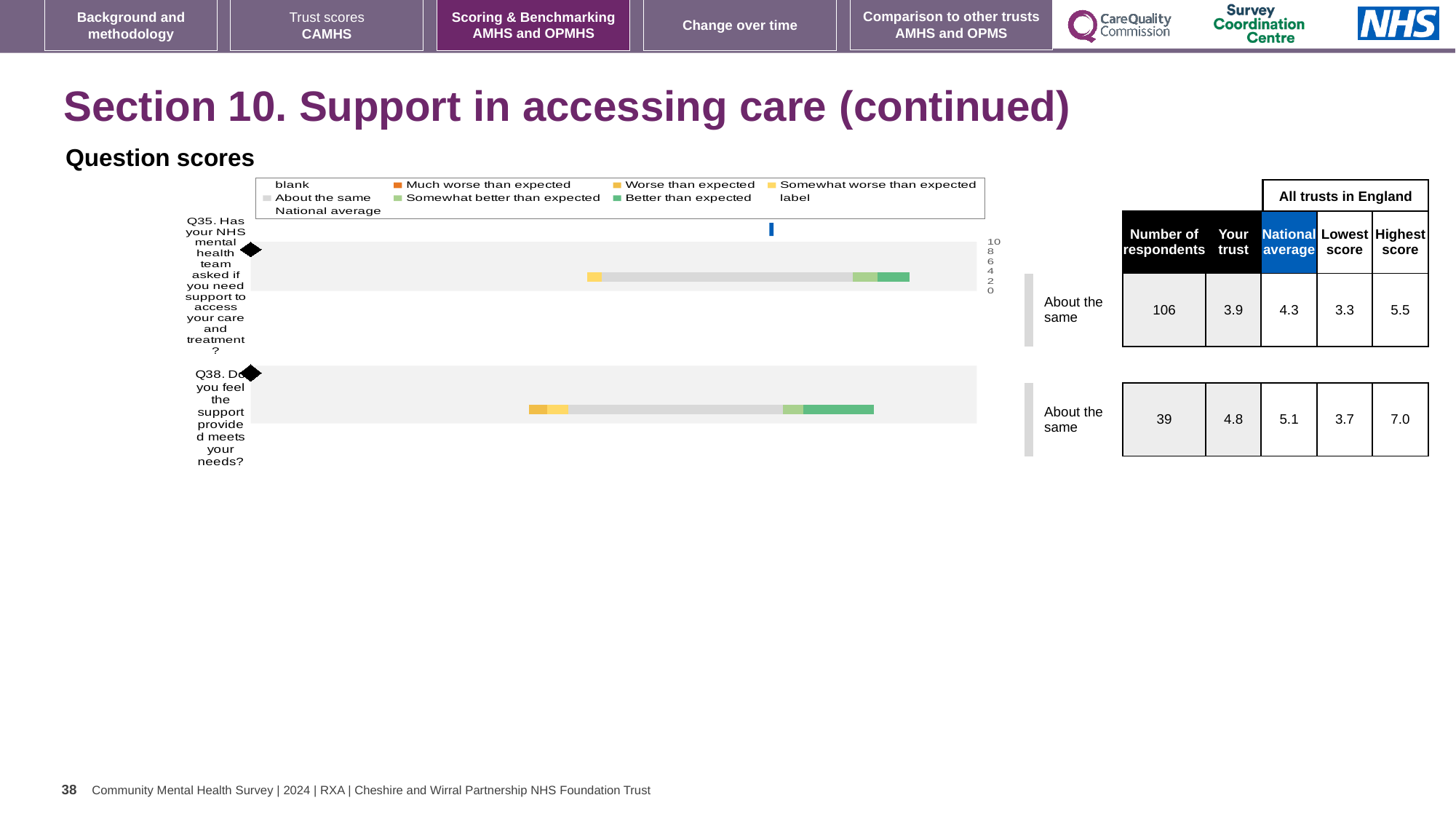
Which question has the higher 'Your trust' score in the table, Q35 or Q38? Q38 In the table beside the chart, what is the highest score across all trusts in England for Q38? 7.0 In the table beside the chart, what is the national average for Q35? 4.3 What is the difference between the highest score and the lowest score for Q38 in the table? 3.3 What kind of chart is used to show the question scores on this slide? bar chart In the table beside the chart, what is the 'Your trust' score for Q38? 4.8 How many questions (categories) are plotted in the question scores chart? 2 In the question scores chart legend, which colour represents 'Better than expected'? green How many entries does the legend of the question scores chart list? 9 What is the highest value shown on the score axis of the question scores chart? 10 What is the difference between the national average and the 'Your trust' score for Q35 in the table? 0.4 In the table beside the chart, how many respondents answered Q35? 106